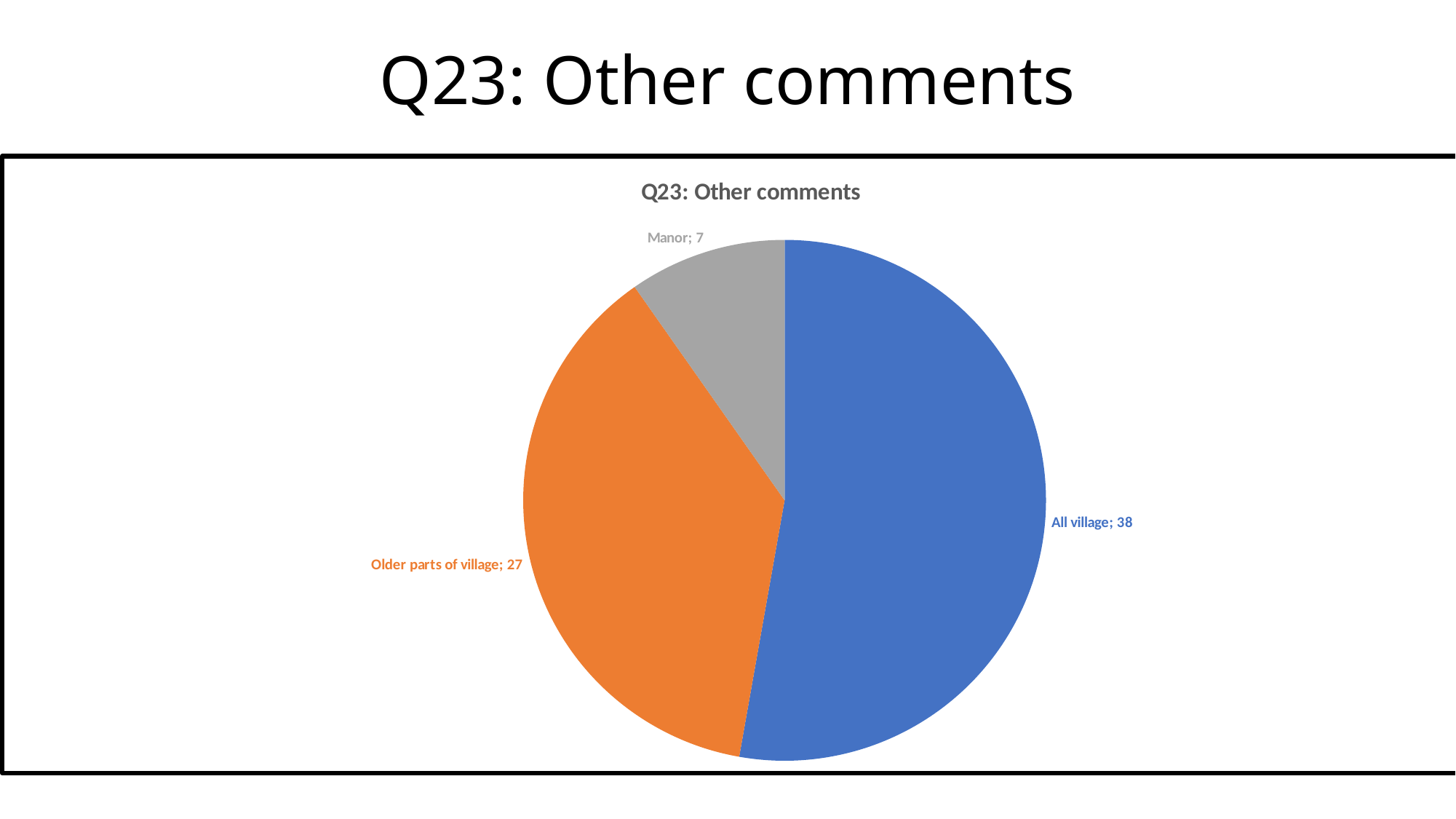
What share of the pie does Older parts of village represent? 37.5% What is the value for All village? 38 What is the title of the chart? Q23: Other comments Which is larger, the value for Older parts of village or the value for Manor? Older parts of village How many slices does the pie chart have? 3 What is the value for Manor? 7 What is the difference between the values for Older parts of village and Manor? 20 Which category has the smallest slice? Manor Which category has the largest slice? All village What kind of chart is shown on the slide? Pie chart What is the difference between the values for All village and Older parts of village? 11 What is the value for Older parts of village? 27